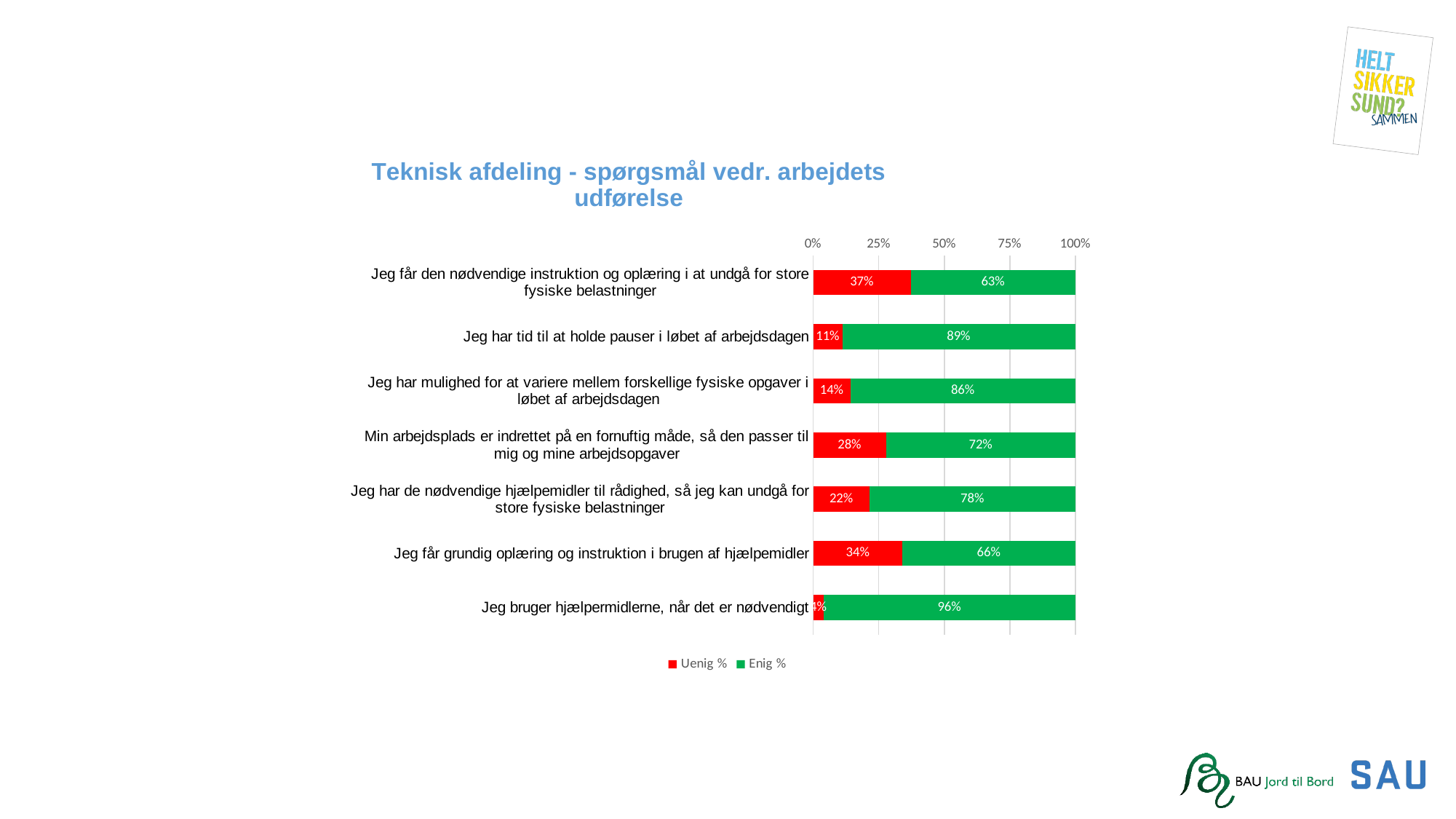
Is the Enig % value for "Jeg har de nødvendige hjælpemidler til rådighed, så jeg kan undgå for store fysiske belastninger" greater or less than 75%? greater What is the difference between the Enig % values for "Jeg har mulighed for at variere mellem forskellige fysiske opgaver i løbet af arbejdsdagen" and "Min arbejdsplads er indrettet på en fornuftig måde, så den passer til mig og mine arbejdsopgaver"? 14% What is the Enig % value for "Jeg bruger hjælpermidlerne, når det er nødvendigt"? 96% Which is larger: the Uenig % for "Jeg får grundig oplæring og instruktion i brugen af hjælpemidler" or the Uenig % for "Jeg har de nødvendige hjælpemidler til rådighed, så jeg kan undgå for store fysiske belastninger"? Jeg får grundig oplæring og instruktion i brugen af hjælpemidler How many series does the legend list? 2 What kind of chart is shown on the slide? Stacked bar chart How many statements (categories) are plotted in the chart? 7 Which colour represents the Enig % series in the chart? Green What is the Enig % value for "Jeg har tid til at holde pauser i løbet af arbejdsdagen"? 89% What is the Uenig % value for "Jeg får den nødvendige instruktion og oplæring i at undgå for store fysiske belastninger"? 37% Which statement has the highest Uenig % value? Jeg får den nødvendige instruktion og oplæring i at undgå for store fysiske belastninger Which statement has the lowest Enig % value? Jeg får den nødvendige instruktion og oplæring i at undgå for store fysiske belastninger